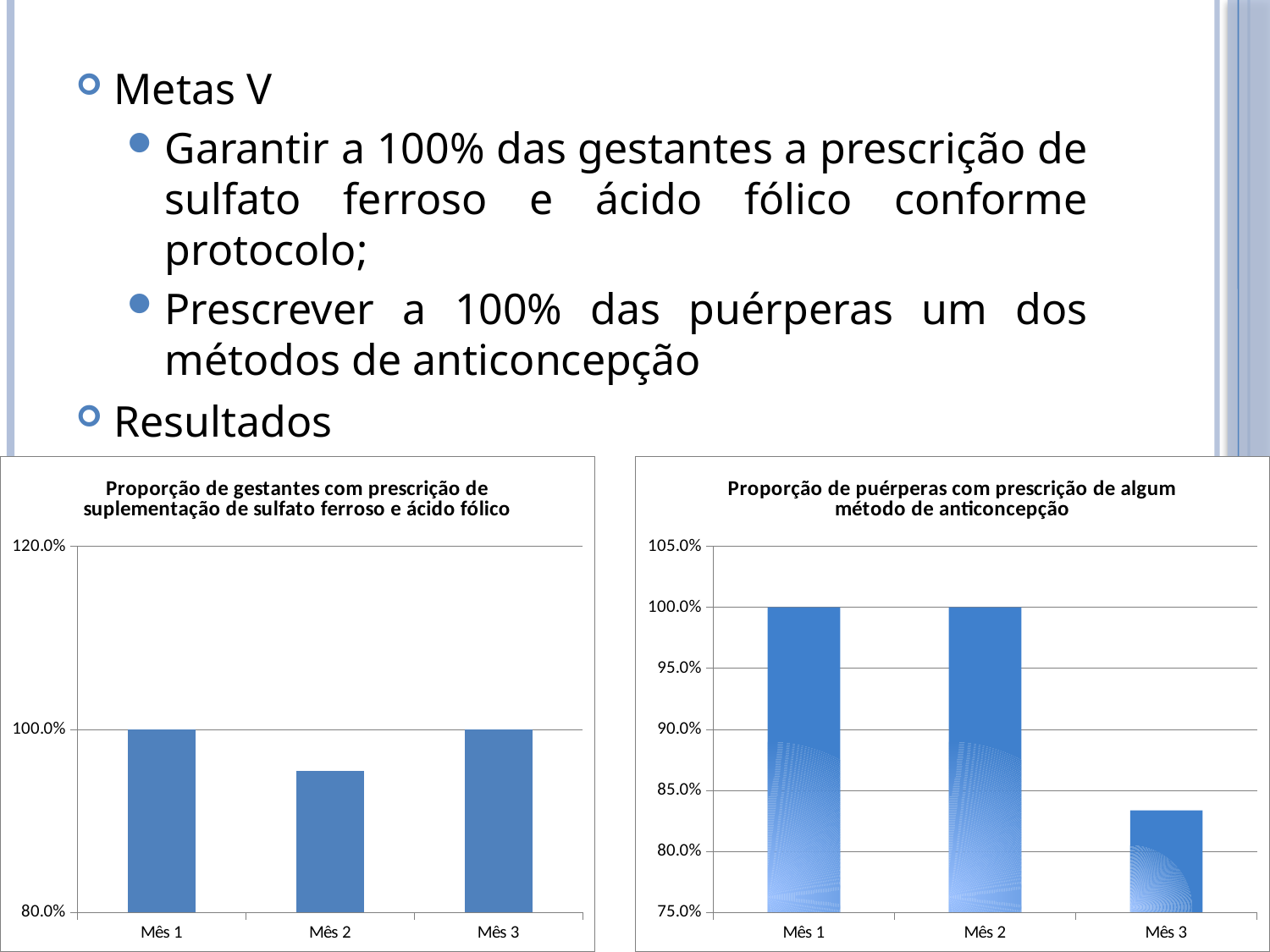
What is the title of the right chart? Proporção de puérperas com prescrição de algum método de anticoncepção In the chart titled "Proporção de puérperas com prescrição de algum método de anticoncepção", which month has the lowest value? Mês 3 In the chart titled "Proporção de gestantes com prescrição de suplementação de sulfato ferroso e ácido fólico", is the value for Mês 2 greater or less than 100.0%? less In the chart titled "Proporção de gestantes com prescrição de suplementação de sulfato ferroso e ácido fólico", what is the value for Mês 1? 100.0% In the chart titled "Proporção de puérperas com prescrição de algum método de anticoncepção", what is the value for Mês 2? 100.0% In the chart titled "Proporção de gestantes com prescrição de suplementação de sulfato ferroso e ácido fólico", which is larger, the value for Mês 1 or Mês 2? Mês 1 In the chart titled "Proporção de puérperas com prescrição de algum método de anticoncepção", what is the value for Mês 1? 100.0% In the chart titled "Proporção de gestantes com prescrição de suplementação de sulfato ferroso e ácido fólico", which month has the lowest value? Mês 2 In the chart titled "Proporção de gestantes com prescrição de suplementação de sulfato ferroso e ácido fólico", what is the value for Mês 3? 100.0% What kind of chart is the left chart? bar chart In the chart titled "Proporção de puérperas com prescrição de algum método de anticoncepção", is the value for Mês 3 greater or less than 85.0%? less How many months are shown in the left chart? 3